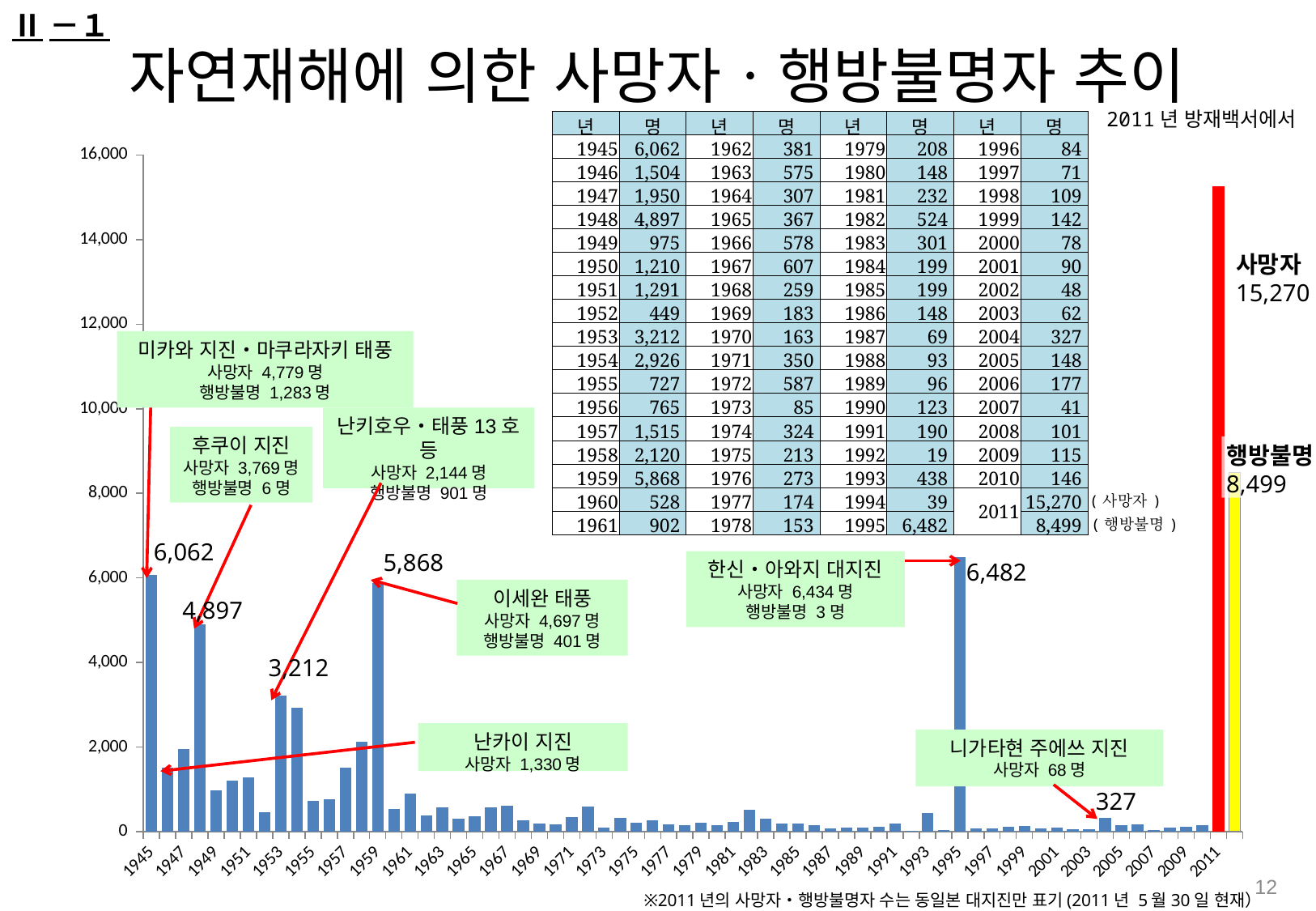
What is the value labelled on the bar for 2004? 327 What is the 사망자 (deaths) value shown for 2011 on the red bar? 15,270 According to the table on the slide, what is the value for 1953? 3,212 Is the value for 1947 greater or less than 2,000? less What is the value labelled on the bar for 1945? 6,062 What is the 행방불명 (missing) value shown for 2011 on the yellow bar? 8,499 What is the difference between the labelled values for 1995 and 1945? 420 What is the value labelled on the bar for 1959? 5,868 Which is larger, the labelled value for 1959 or for 1948? 1959 What type of chart is shown on the slide? bar chart Which year has the tallest bar in the chart? 2011 What is the value labelled on the bar for 1995? 6,482